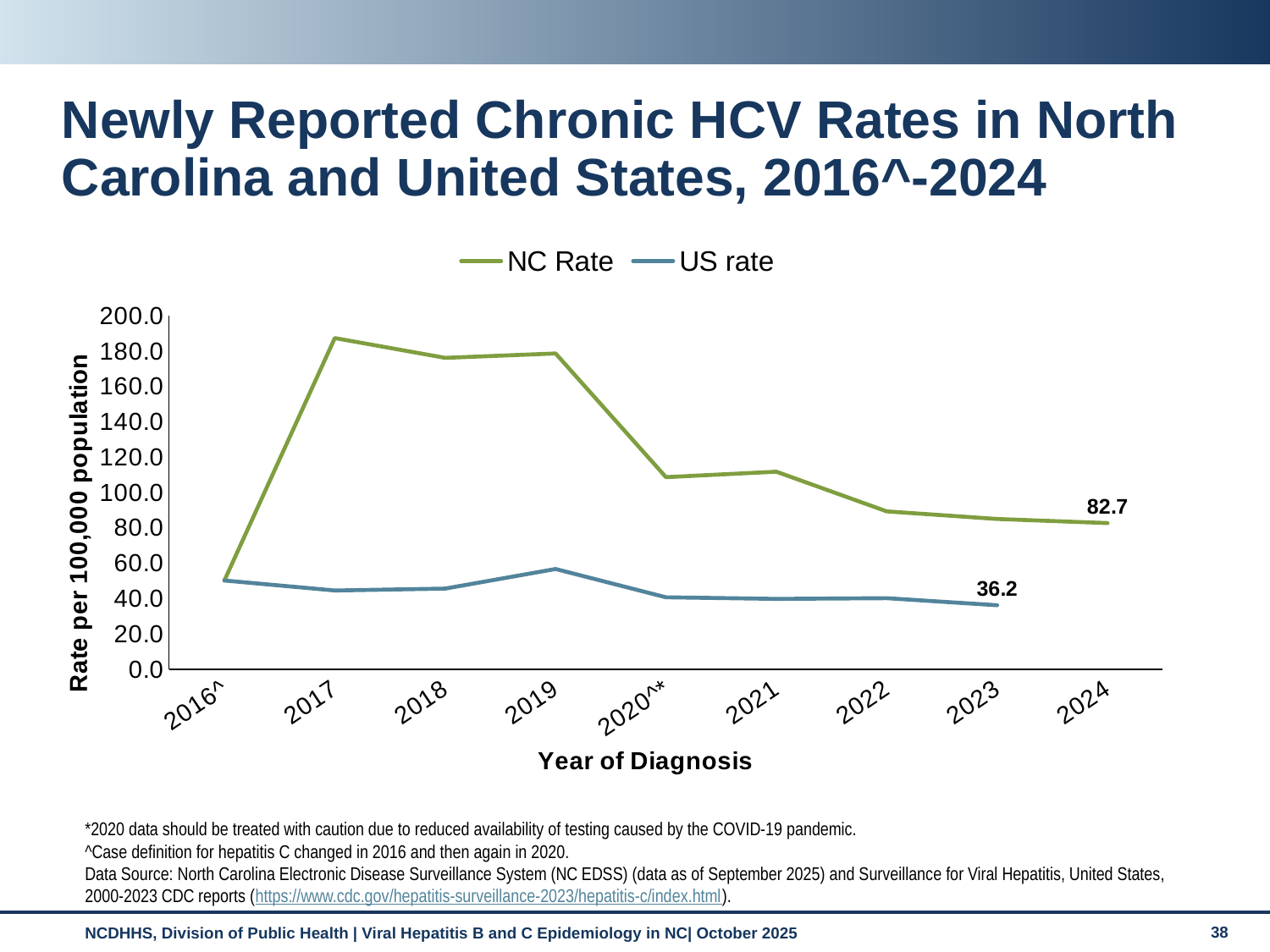
Is the NC Rate for 2022 greater or less than 100? less What is the difference between the labelled NC Rate for 2024 and the labelled US rate for 2023? 46.5 In which year is the US rate highest? 2019 Is the NC Rate for 2017 greater or less than 180? greater In which year is the NC Rate lowest? 2016^ How many series does the legend list? 2 What kind of chart is shown on the slide? Line chart What is the NC Rate for 2024? 82.7 Which series has the higher value in 2019, NC Rate or US rate? NC Rate How many years are shown on the x axis? 9 What is the US rate for 2023? 36.2 In which year is the NC Rate highest? 2017